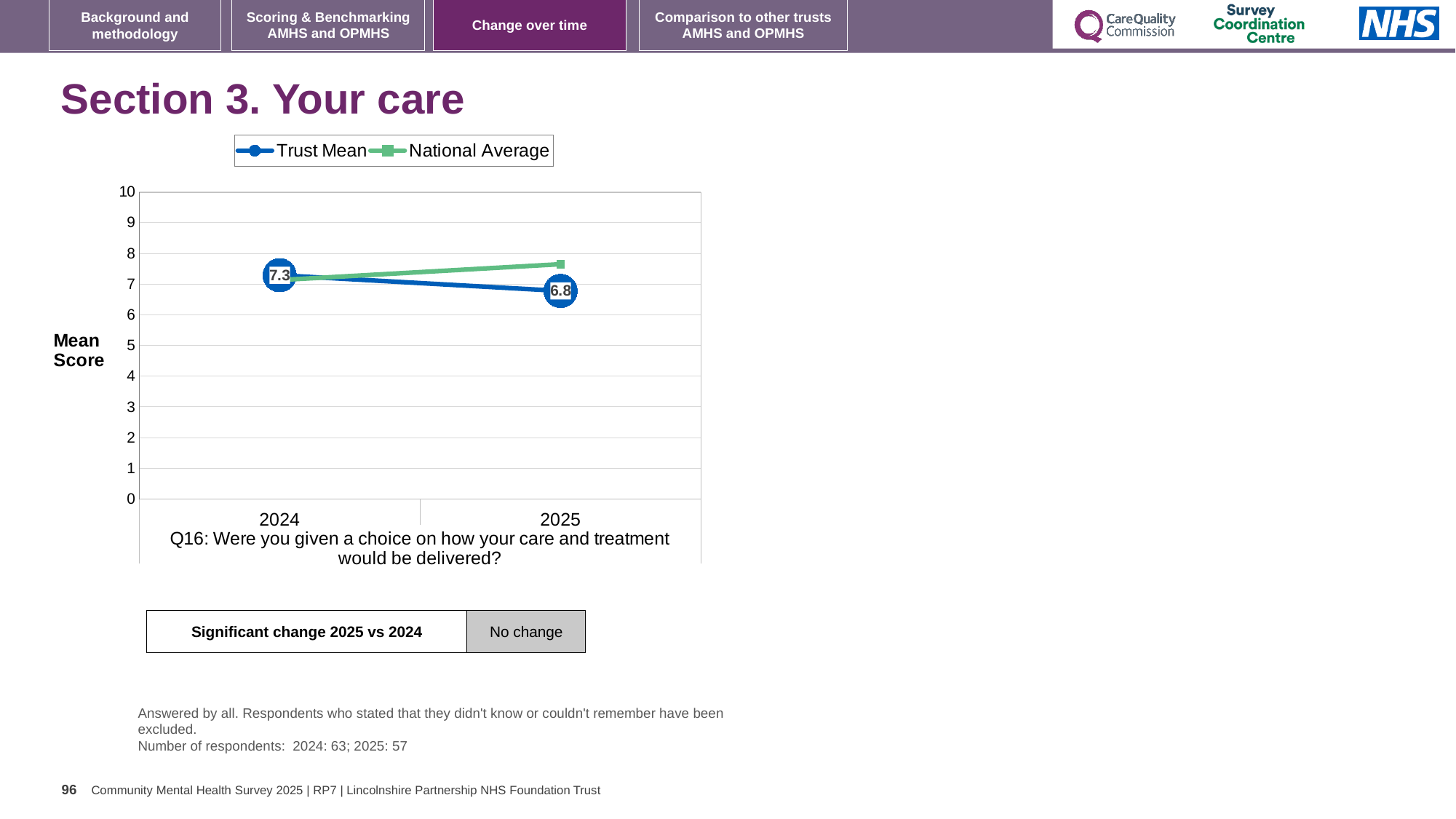
Is the National Average value for 2024 greater or less than 8? less Is the National Average value for 2025 greater or less than 7? greater How many series does the legend list? 2 What kind of chart is shown on the slide? Line chart In which year is the Trust Mean score lowest? 2025 How many years are plotted on the x axis? 2 In which year is the Trust Mean score highest? 2024 By how much did the Trust Mean score change from 2024 to 2025? 0.5 What is the Trust Mean score for 2024? 7.3 What is the Trust Mean score for 2025? 6.8 In 2025, which is higher: the Trust Mean or the National Average? National Average Does the Trust Mean rise or fall from 2024 to 2025? Fall